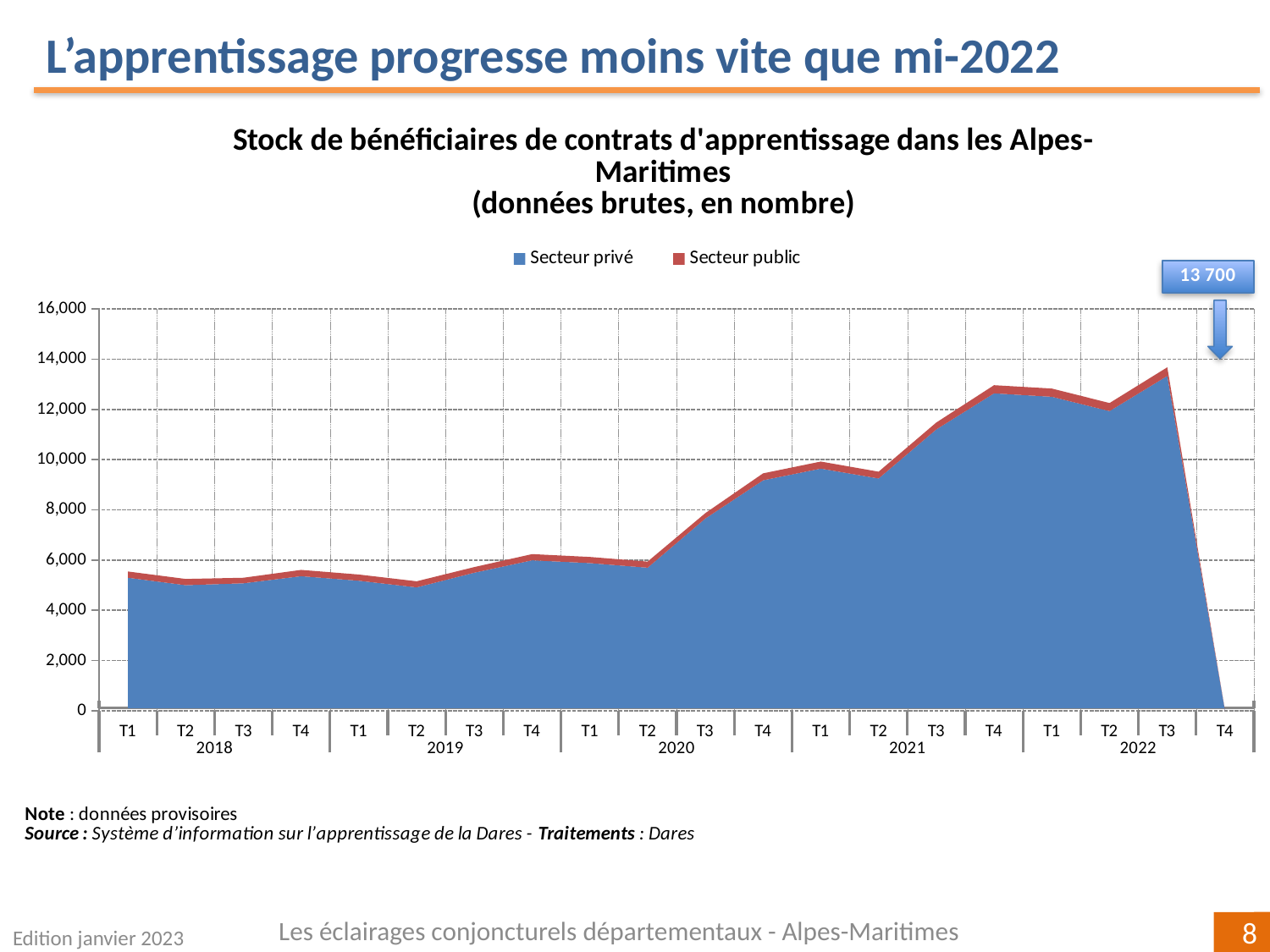
Which is larger, the total for T1 2020 or the total for T1 2021? T1 2021 Which series accounts for the larger part of the stacked area, Secteur privé or Secteur public? Secteur privé How many series does the legend list? 2 Is the total value for T4 2021 greater or less than 12,000? greater What kind of chart is shown on the slide? Stacked area chart How many quarters are shown on the x axis? 20 What value does the callout annotation above the chart show? 13 700 Is the total value for T4 2020 greater or less than 8,000? greater Is the total value for T1 2018 greater or less than 6,000? less What are the two series named in the legend? Secteur privé and Secteur public Which quarter has the highest total stock of apprenticeship contracts? T3 2022 Do the values rise or fall between T2 2020 and T4 2021? rise